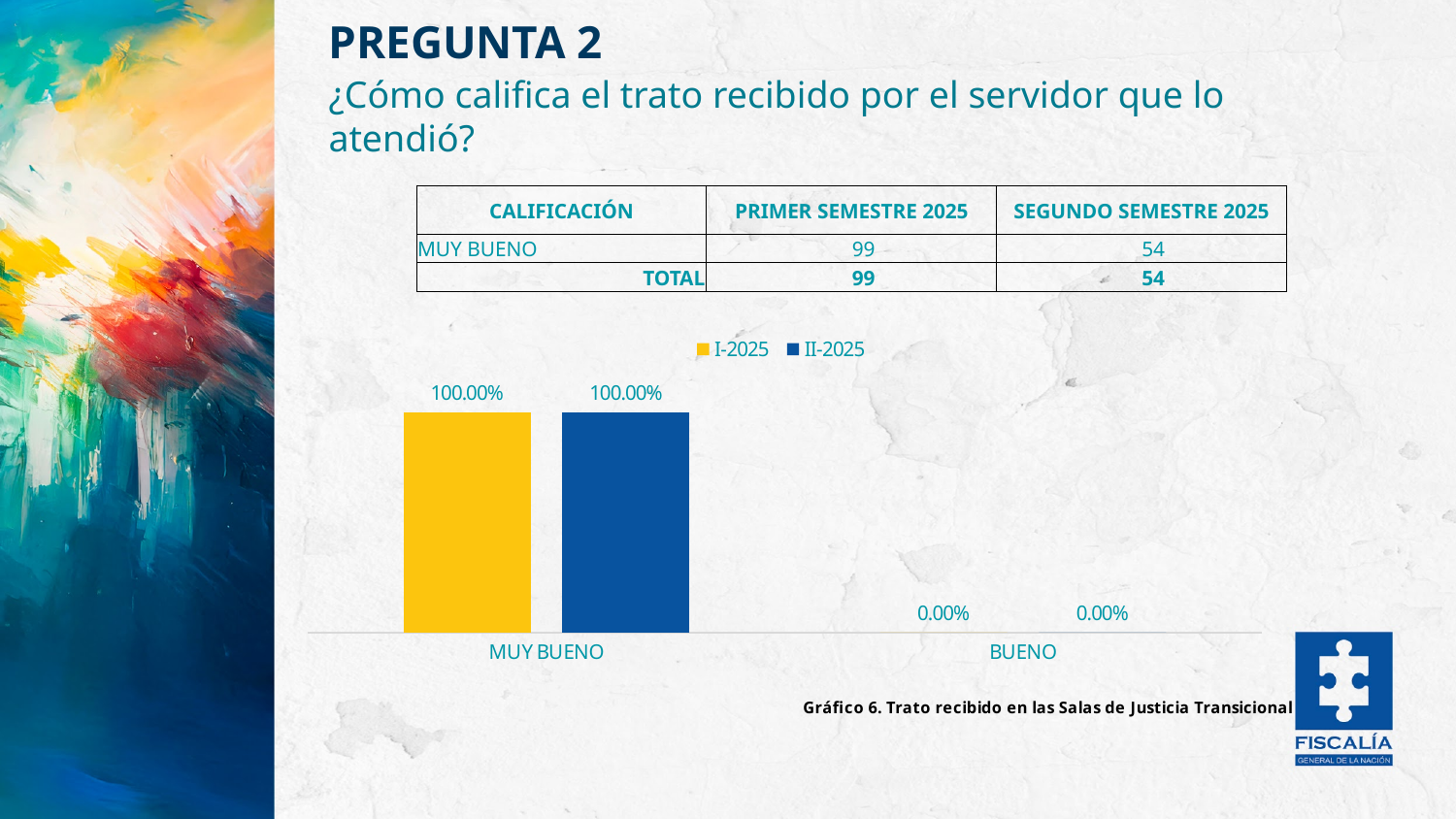
What is the value for BUENO in the II-2025 series? 0.00% Which category has the lowest value in the I-2025 series? BUENO How many categories are shown on the x axis of the chart? 2 How many series does the legend list? 2 Which is larger: the II-2025 value for MUY BUENO or for BUENO? MUY BUENO Which category has the highest value in the II-2025 series? MUY BUENO What colour are the bars for the I-2025 series? Yellow What is the value for MUY BUENO in the I-2025 series? 100.00% What kind of chart is shown on the slide? Bar chart Do the values fall or rise from MUY BUENO to BUENO along the x axis? Fall What is the difference between the I-2025 values for MUY BUENO and BUENO? 100.00% What is the value for BUENO in the I-2025 series? 0.00%